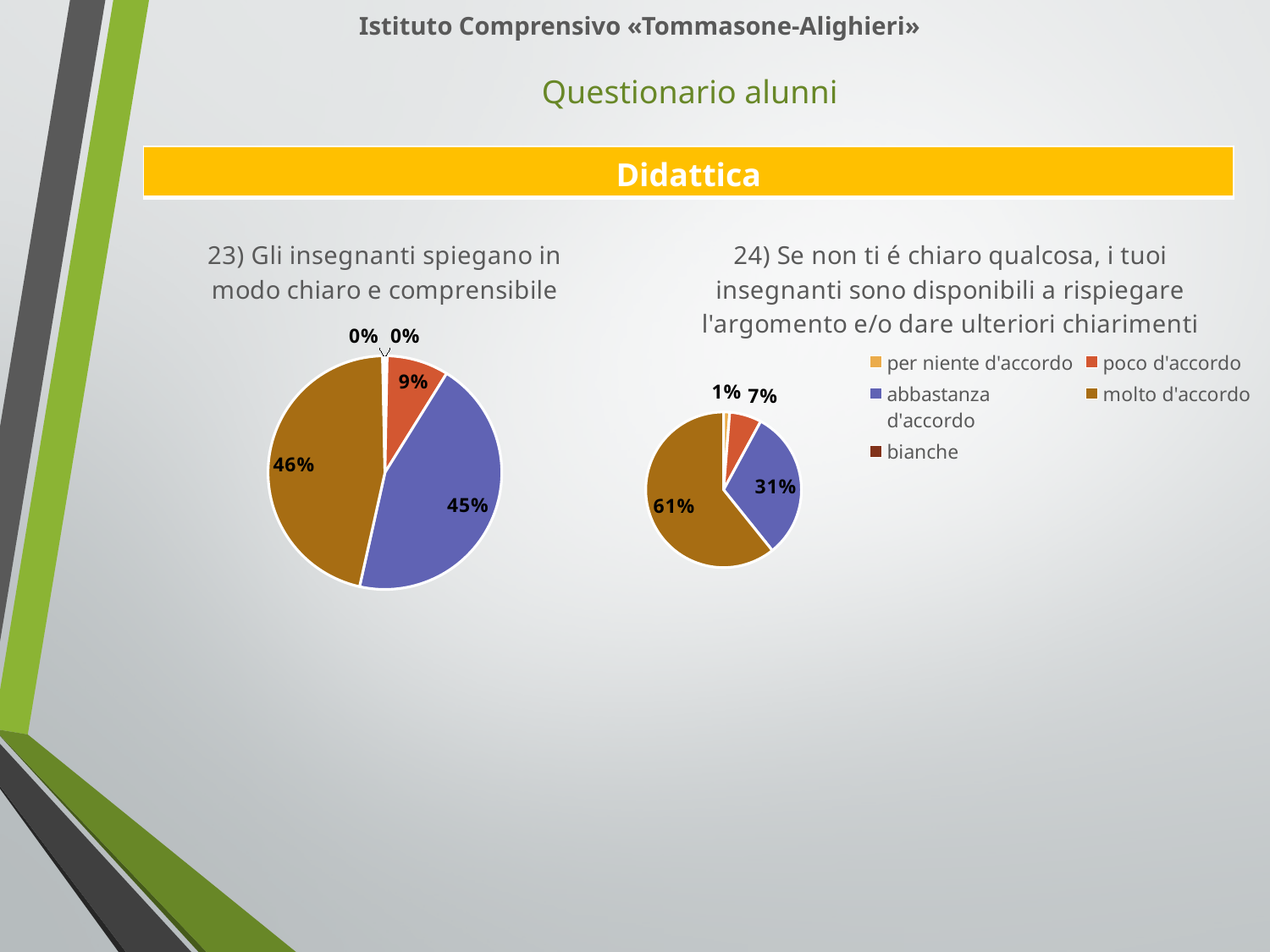
In the chart for question 24, which category has the largest slice? molto d'accordo In the chart for question 24 (Se non ti é chiaro qualcosa...), what share is 'molto d'accordo'? 61% In the chart for question 23, what share is 'molto d'accordo'? 46% In the chart for question 23 (Gli insegnanti spiegano in modo chiaro e comprensibile), what share is 'abbastanza d'accordo'? 45% What kind of chart is used for question 23 on the left of the slide? pie chart In the chart for question 24, what is the difference between the 'molto d'accordo' and 'abbastanza d'accordo' shares? 30% In the chart for question 23, which is larger: 'poco d'accordo' or 'abbastanza d'accordo'? abbastanza d'accordo How many entries does the legend next to the question 24 chart list? 5